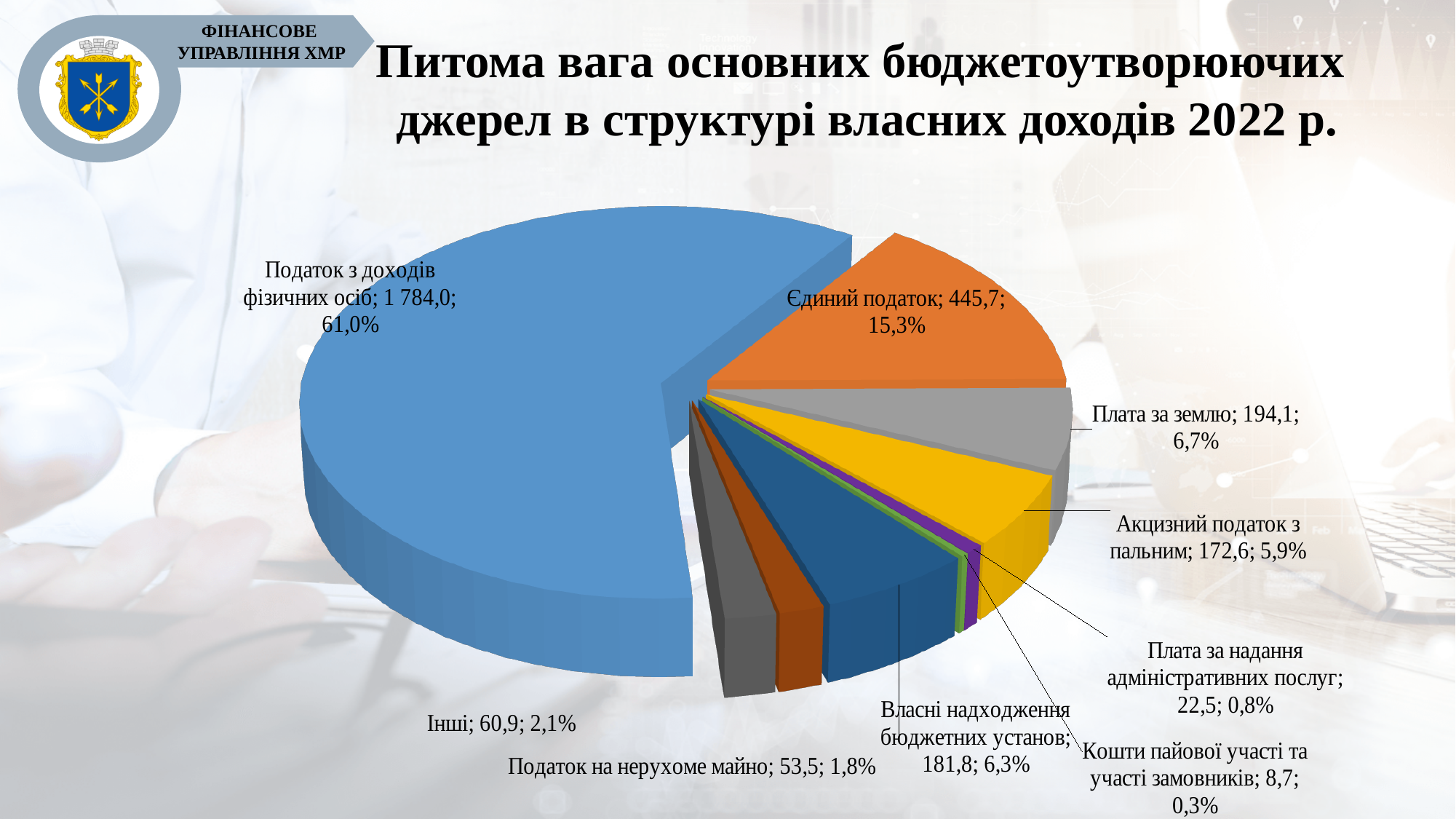
Which category has the largest slice of the pie? Податок з доходів фізичних осіб What is the value shown for "Плата за землю"? 194,1 What is the difference in percentage points between "Єдиний податок" (15,3%) and "Плата за землю" (6,7%)? 8,6 What is the value shown for "Інші"? 60,9 Which is larger: "Власні надходження бюджетних установ" or "Податок на нерухоме майно"? Власні надходження бюджетних установ What share of the pie does "Податок з доходів фізичних осіб" represent? 61,0% Which category has the smallest slice of the pie? Кошти пайової участі та участі замовників What kind of chart is shown on the slide? Pie chart How many slices (categories) does the pie chart have? 9 What percentage is shown for "Акцизний податок з пальним"? 5,9% What is the value shown for "Єдиний податок"? 445,7 What is the title of the chart on the slide? Питома вага основних бюджетоутворюючих джерел в структурі власних доходів 2022 р.